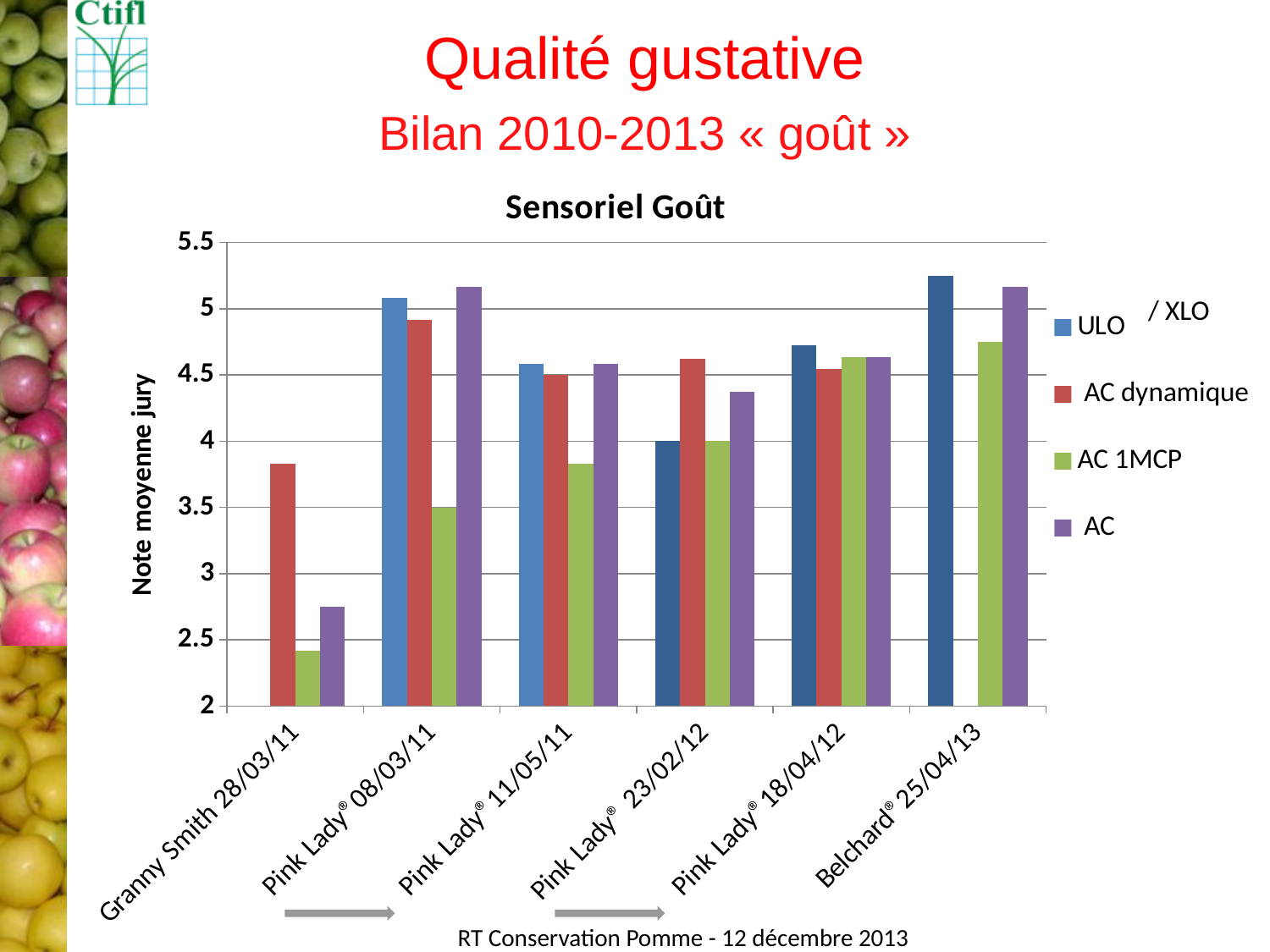
What is the title of the chart? Sensoriel Goût For Granny Smith 28/03/11, which is larger: AC dynamique or AC? AC dynamique Which series has the lowest bar for Granny Smith 28/03/11? AC 1MCP What is the label of the vertical axis? Note moyenne jury How many categories are shown on the x axis? 6 How many series does the legend list? 4 Which category has the highest bar in the chart? Belchard® 25/04/13 Is the value of AC dynamique for Granny Smith 28/03/11 greater or less than 3.5? greater Is the value of ULO for Belchard® 25/04/13 greater or less than 5? greater What type of chart is shown on the slide? bar chart Is the value of AC 1MCP for Granny Smith 28/03/11 greater or less than 2.5? less For Pink Lady® 08/03/11, which is larger: ULO or AC 1MCP? ULO